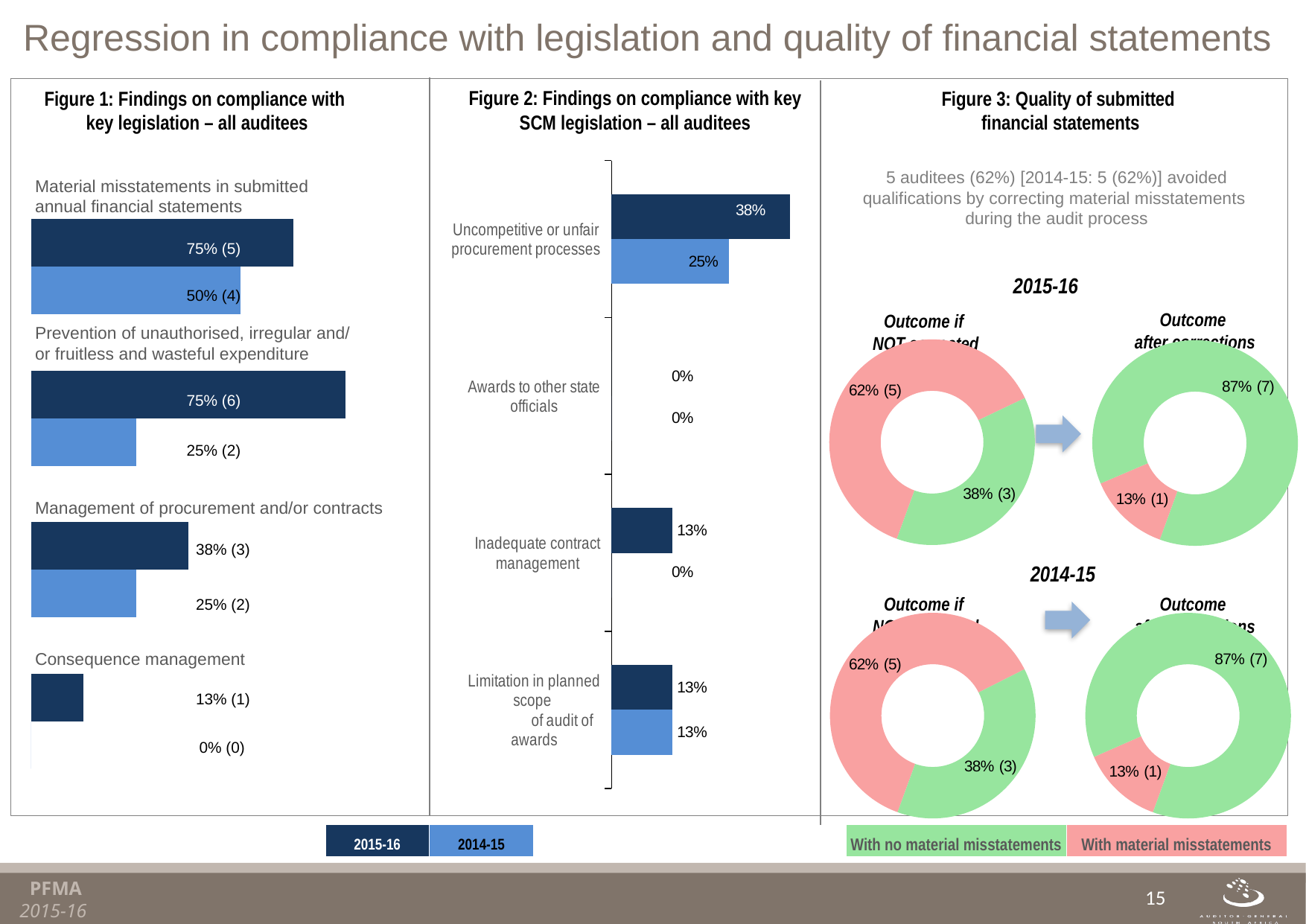
In Figure 2, which category has the highest 2015-16 value? Uncompetitive or unfair procurement processes In Figure 2, what is the 2015-16 value for Uncompetitive or unfair procurement processes? 38% In Figure 1, what is the 2015-16 value for Material misstatements in submitted annual financial statements? 75% (5) In Figure 3, for 2015-16, what share of auditees had no material misstatements in the outcome after corrections? 87% (7) In Figure 1, which category has the lowest 2015-16 value? Consequence management How many series does the legend at the bottom of the slide list for Figures 1 and 2? 2 In Figure 1, what is the 2014-15 value for Prevention of unauthorised, irregular and/or fruitless and wasteful expenditure? 25% (2) What type of chart is Figure 2? Bar chart In Figure 1, what is the difference in percentage points between the 2015-16 and 2014-15 values for Management of procurement and/or contracts? 13 percentage points In Figure 1, how many categories are shown? 4 In Figure 3, for 2015-16, is the 'with material misstatements' share larger in the outcome if not corrected or in the outcome after corrections? Outcome if not corrected In Figure 2, what is the 2014-15 value for Inadequate contract management? 0%